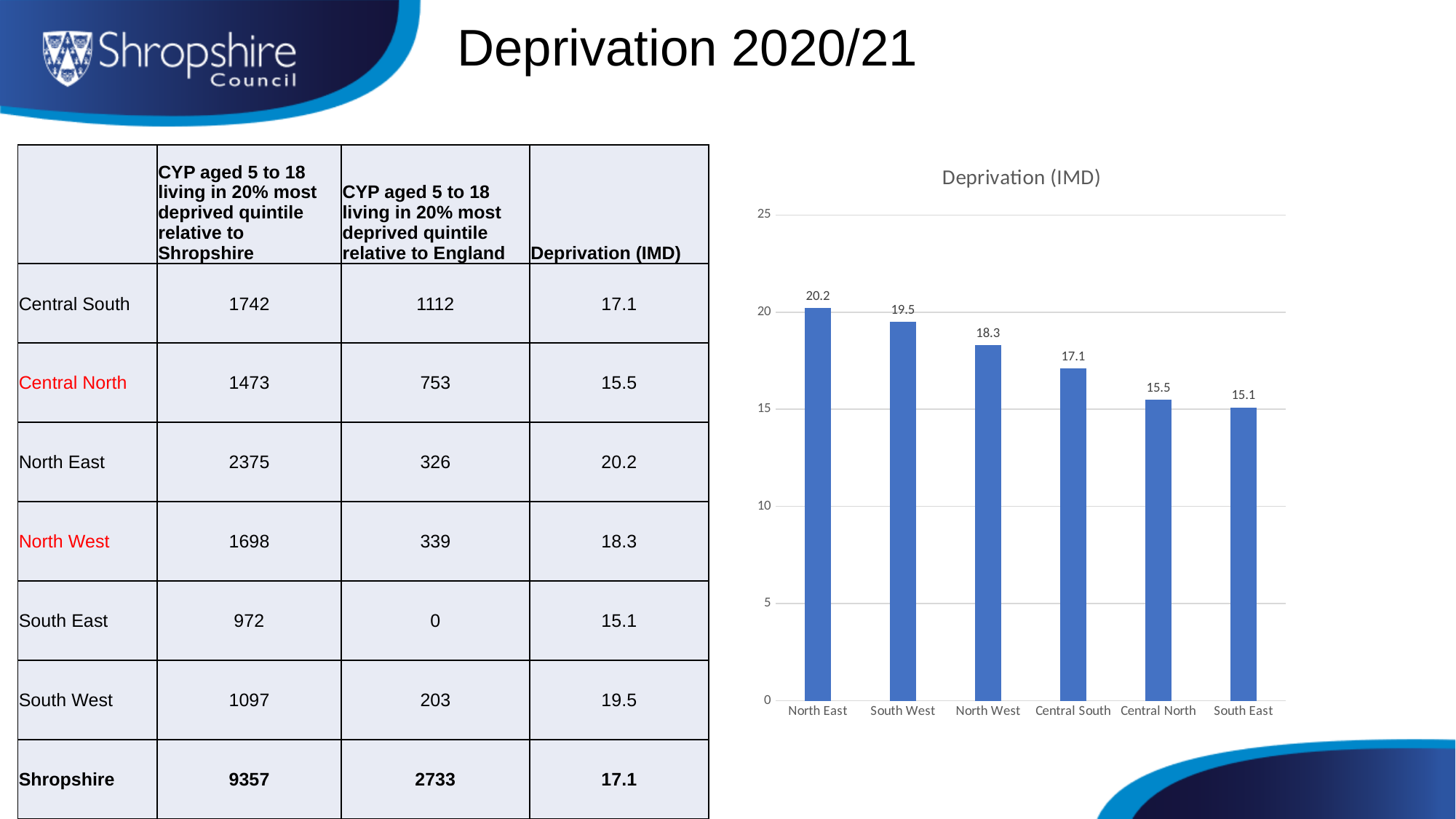
What is the Deprivation (IMD) value for North East? 20.2 What is the difference between the Deprivation (IMD) values for North East and South East? 5.1 What type of chart is used to show Deprivation (IMD)? bar chart Which area has the highest Deprivation (IMD) value in the chart? North East What is the Deprivation (IMD) value for Central North? 15.5 What is the difference between the Deprivation (IMD) values for North West and Central South? 1.2 Which area has the lowest Deprivation (IMD) value in the chart? South East How many areas are shown in the Deprivation (IMD) chart? 6 What is the Deprivation (IMD) value for South West? 19.5 Which has a higher Deprivation (IMD) value, South West or North West? South West Do the Deprivation (IMD) values rise or fall from left to right across the chart? fall Is the Deprivation (IMD) value for Central South greater or less than 20? less